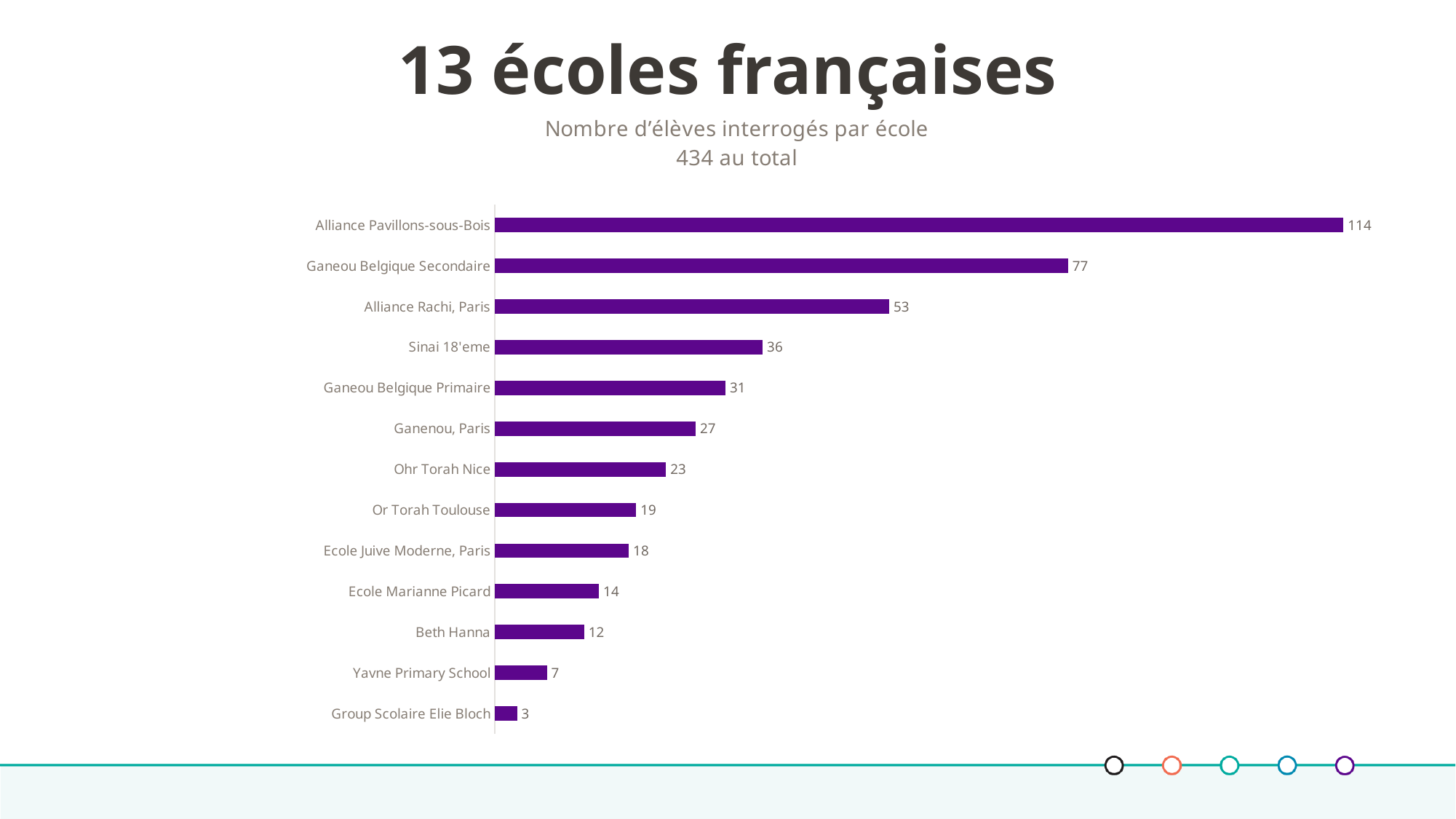
What total number of students is stated in the chart subtitle? 434 How many students were surveyed at Alliance Pavillons-sous-Bois? 114 Which school has the highest number of students surveyed? Alliance Pavillons-sous-Bois What is the value for Ecole Marianne Picard? 14 What is the difference between Ganeou Belgique Secondaire and Ganeou Belgique Primaire? 46 What kind of chart is shown on the slide? Bar chart What is the difference between Alliance Rachi, Paris and Ohr Torah Nice? 30 Which has a larger value, Ganenou, Paris or Or Torah Toulouse? Ganenou, Paris How many schools are shown in the chart? 13 What is the value for Sinai 18'eme? 36 Which school has the lowest number of students surveyed? Group Scolaire Elie Bloch Which has a larger value, Beth Hanna or Yavne Primary School? Beth Hanna